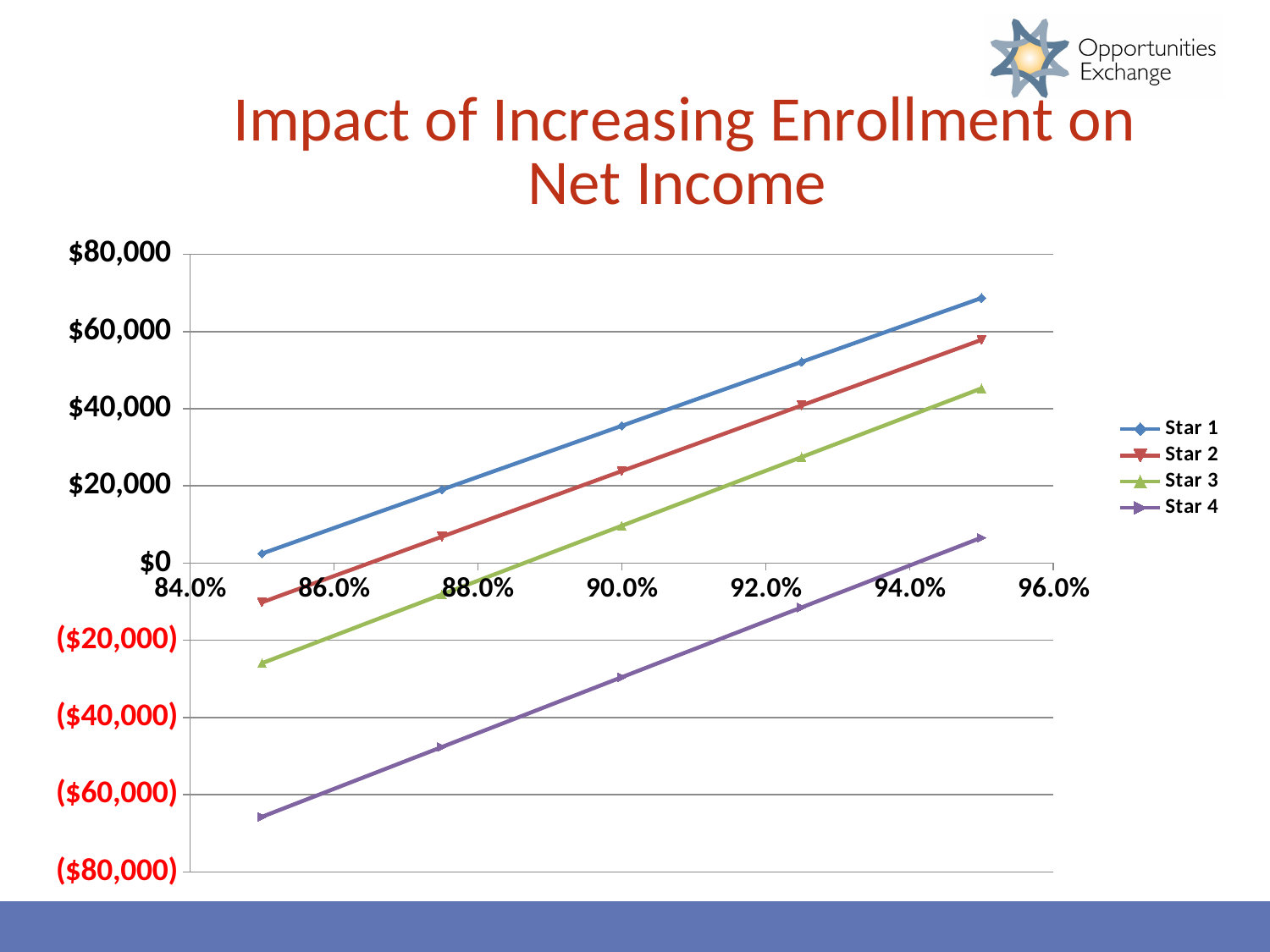
How many data points are plotted for the Star 1 series? 5 What kind of chart is shown on the slide? line chart Is the value for Star 4 at 90.0% enrollment greater or less than ($20,000)? less At 90.0% enrollment, which is larger: the value for Star 2 or the value for Star 4? Star 2 Is the value for Star 4 at 85.0% enrollment greater or less than ($60,000)? less How many series does the legend list? 4 Is the value for Star 1 at 95.0% enrollment greater or less than $60,000? greater Which series has the lowest net income at 85.0% enrollment? Star 4 Do the net income values rise or fall as enrollment increases along the x axis? rise What is the title of the chart? Impact of Increasing Enrollment on Net Income Which series has the highest net income at 95.0% enrollment? Star 1